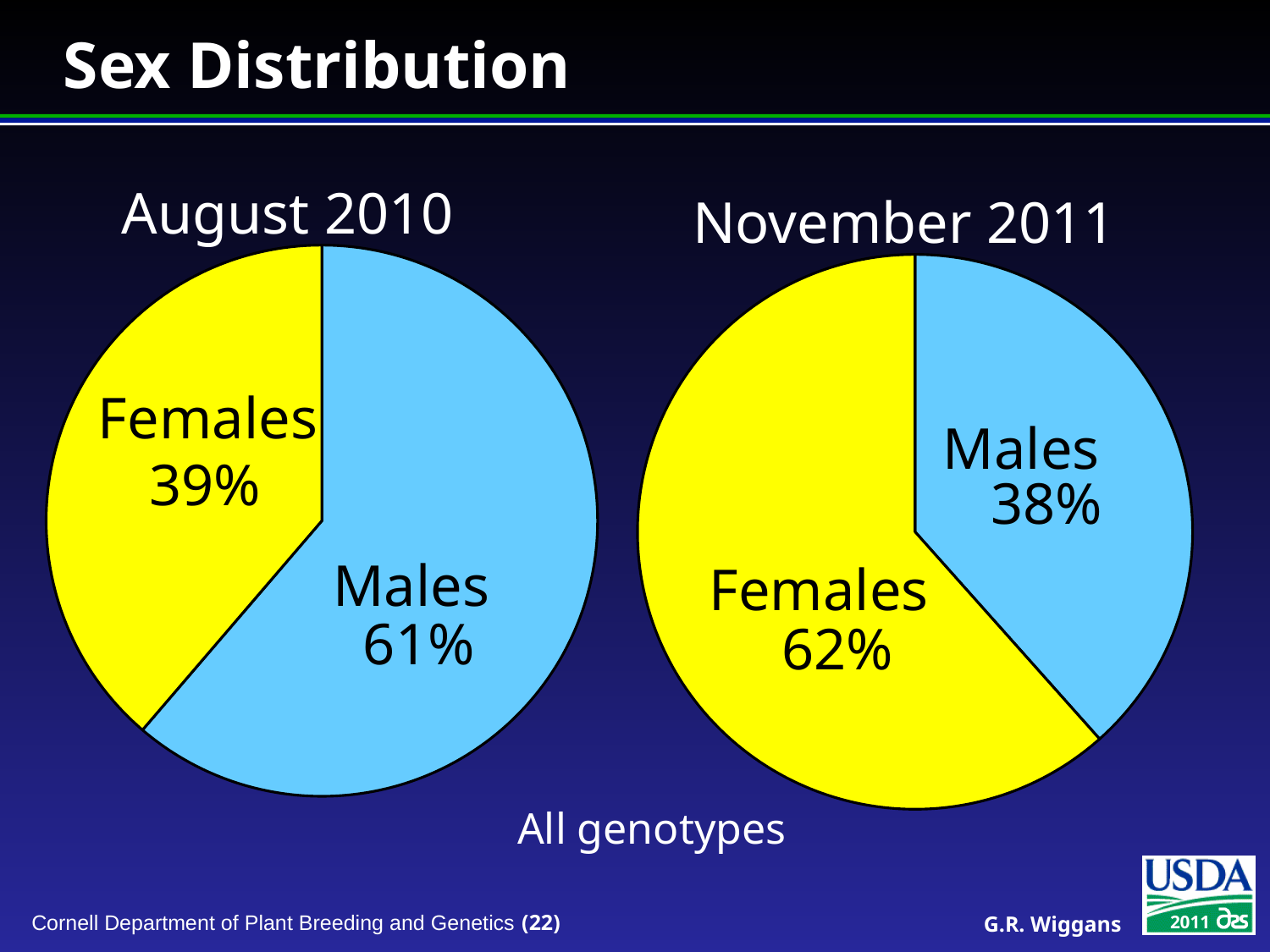
In the August 2010 pie chart, what is the difference between the Males and Females shares? 22% What kind of chart is used for August 2010? Pie chart In the November 2011 pie chart, which slice is the smallest? Males How many slices does the November 2011 pie chart have? 2 In the November 2011 pie chart, what share of the pie is Females? 62% In the August 2010 pie chart, which slice is the largest? Males What colour is the Females slice in the August 2010 pie chart? Yellow In the August 2010 pie chart, what share of the pie is Females? 39% Is the Females share larger in the August 2010 chart or the November 2011 chart? November 2011 In the November 2011 pie chart, what is the difference between the Females and Males shares? 24% In the August 2010 pie chart, what share of the pie is Males? 61%